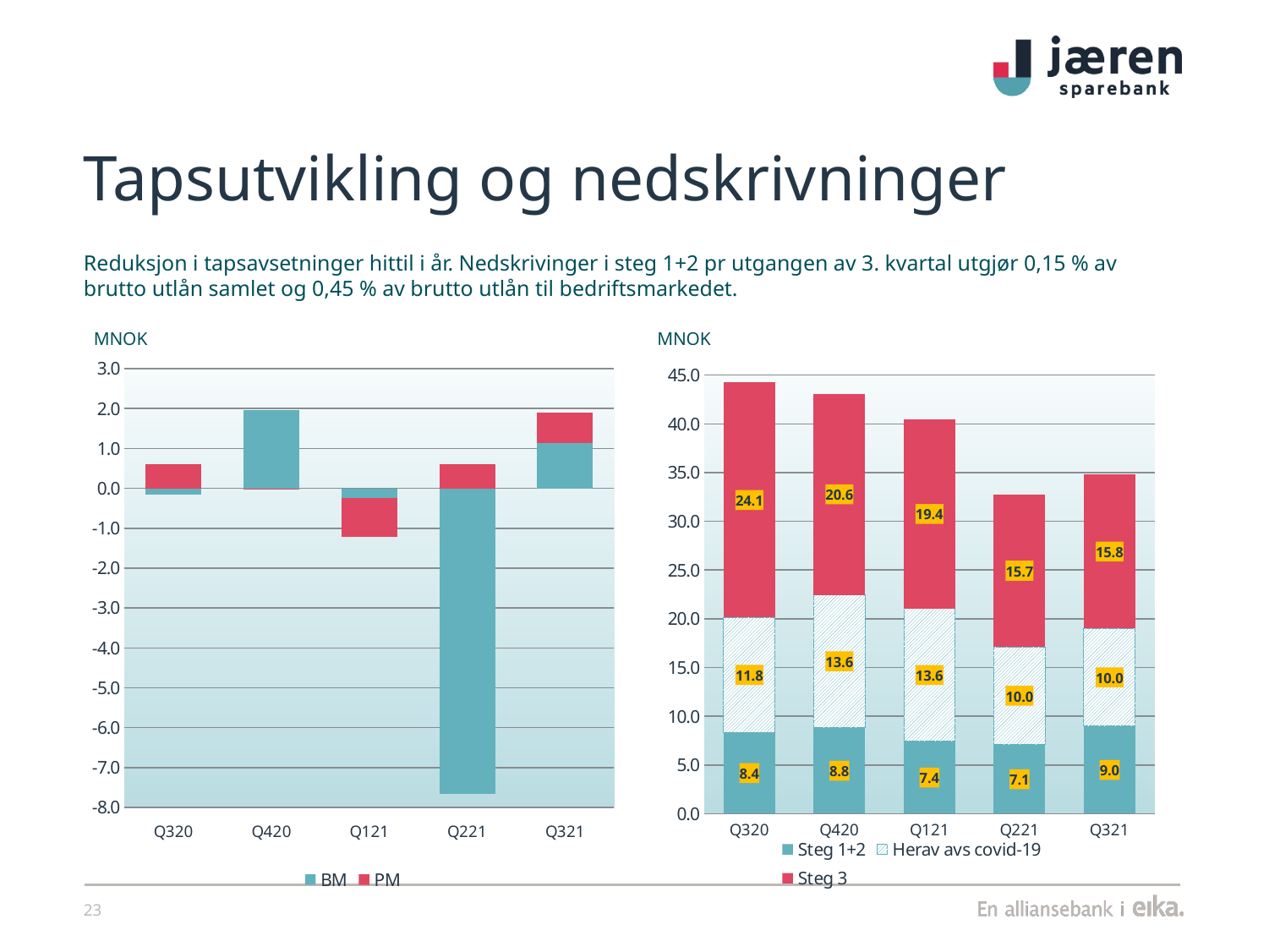
In the left-hand chart (BM and PM), how many quarters are shown on the x axis? 5 In the left-hand chart, how many series does the legend list? 2 In the left-hand chart, is the BM value for Q221 greater or less than -7.0? less In the right-hand chart, which quarter has the highest Steg 3 value? Q320 In the right-hand chart, which is larger: the Herav avs covid-19 value for Q420 or for Q221? Q420 In the right-hand chart, what is the Steg 3 value for Q320? 24.1 In the right-hand chart, what is the total of the stacked bar for Q221? 32.8 What kind of chart is the right-hand chart (with Steg 1+2, Herav avs covid-19 and Steg 3)? Bar chart In the right-hand chart, how many series does the legend list? 3 In the right-hand chart, which quarter has the lowest Steg 1+2 value? Q221 In the right-hand chart, what is the Steg 1+2 value for Q321? 9.0 In the right-hand chart, what is the difference between the Steg 3 values for Q320 and Q420? 3.5